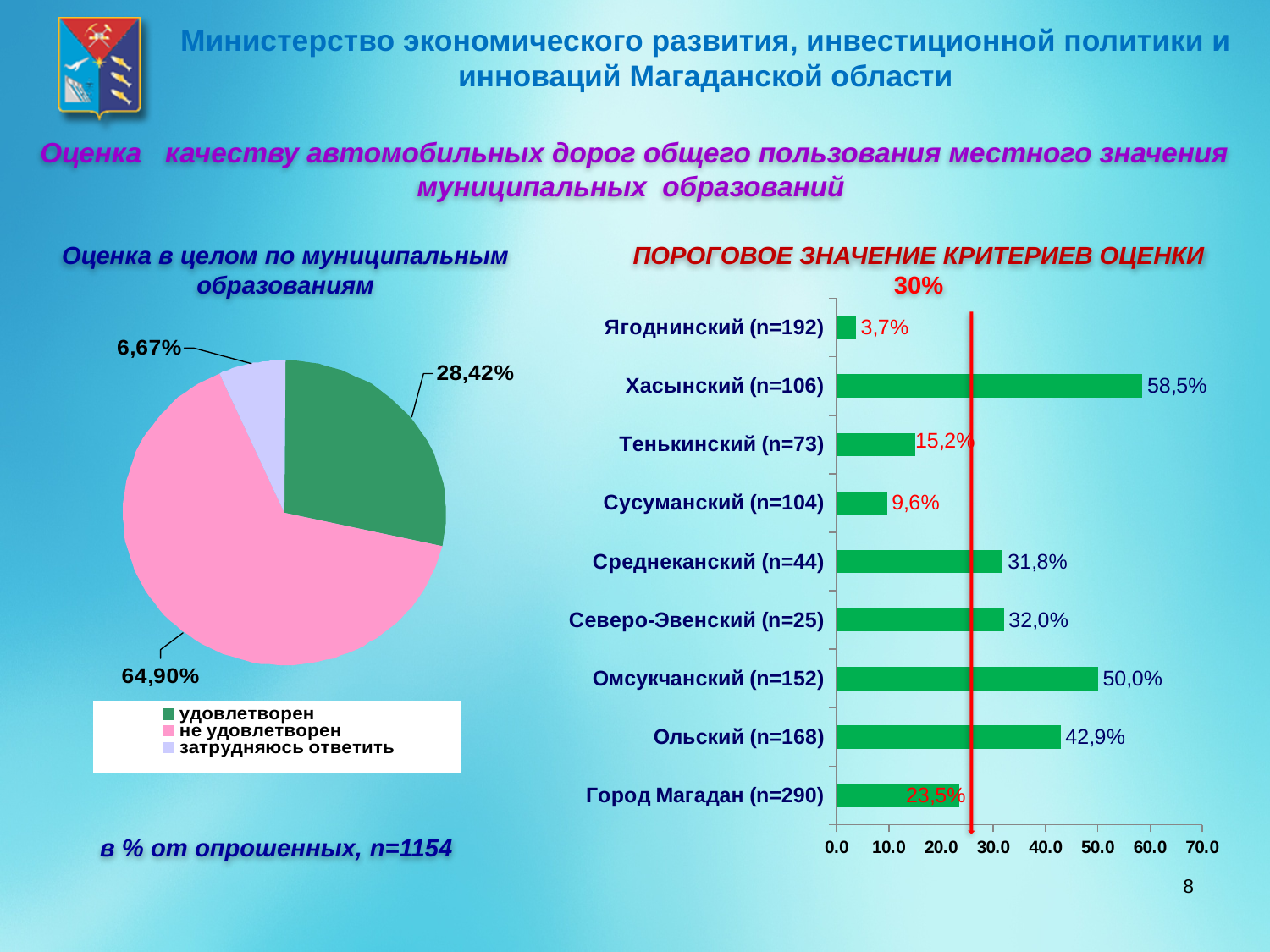
In the bar chart on the right, which municipality has the highest value? Хасынский (n=106) In the bar chart on the right, what is the value for Хасынский (n=106)? 58,5% In the bar chart on the right, what is the value for Город Магадан (n=290)? 23,5% In the pie chart on the left, how many categories does the legend list? 3 In the pie chart on the left, which category has the smallest slice? затрудняюсь ответить In the bar chart on the right, what is the difference between the values for Омсукчанский (n=152) and Ольский (n=168)? 7,1% In the bar chart on the right, which municipality has the lowest value? Ягоднинский (n=192) In the bar chart on the right, how many municipalities are plotted? 9 What type of chart is shown on the right side of the slide? bar chart In the bar chart on the right, which is larger: the value for Тенькинский (n=73) or Сусуманский (n=104)? Тенькинский (n=73) In the pie chart on the left, what share of respondents answered "удовлетворен"? 28,42% In the pie chart on the left, what share of respondents answered "не удовлетворен"? 64,90%